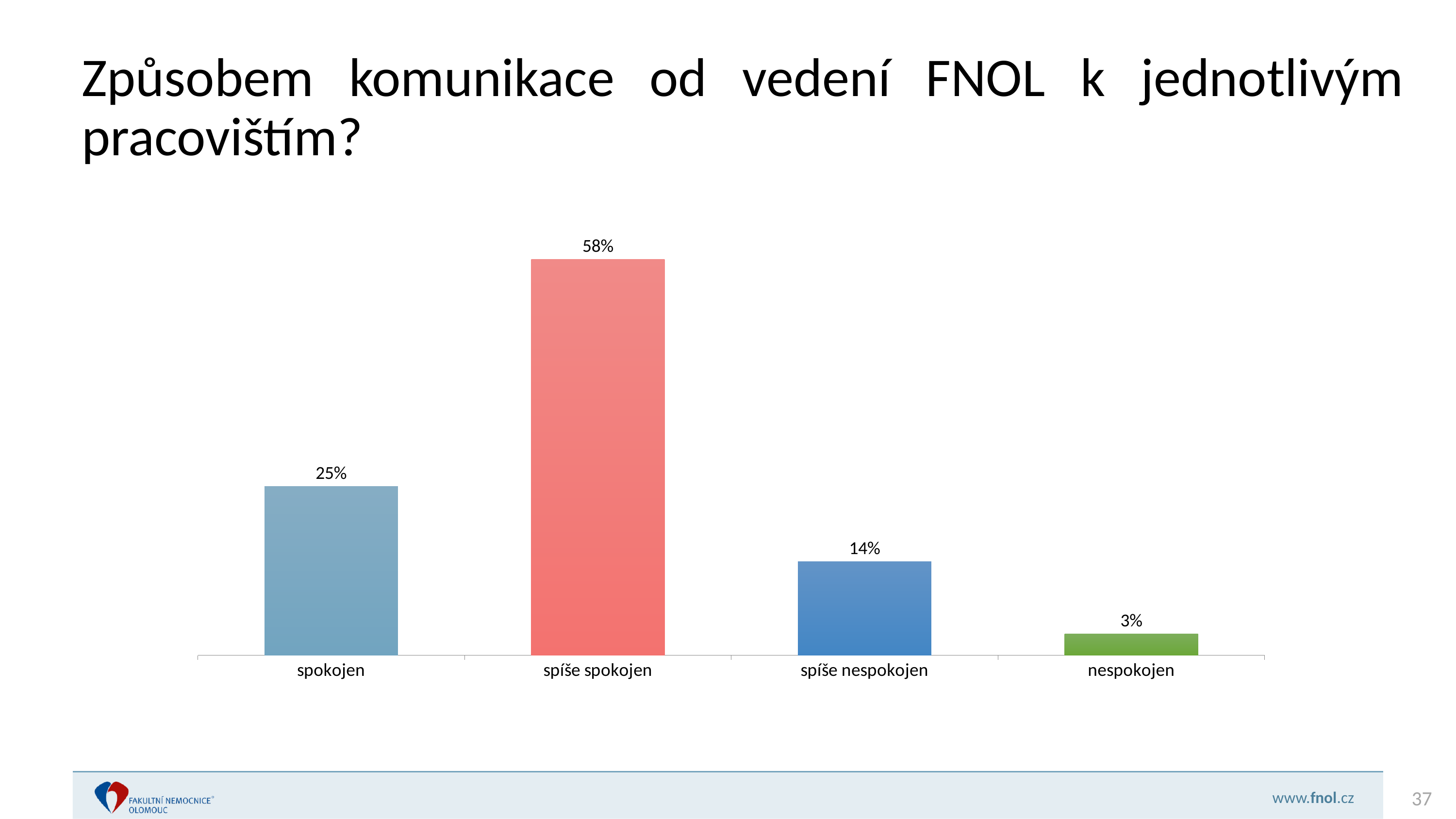
What is the value for "spokojen"? 25% What is the value for "spíše nespokojen"? 14% What kind of chart is shown on the slide? bar chart What is the value for "spíše spokojen"? 58% Which category has the highest value? spíše spokojen How many categories are shown on the x axis? 4 What is the value for "nespokojen"? 3% What is the difference between the values for "spíše nespokojen" and "nespokojen"? 11% Which category has the lowest value? nespokojen What colour is the bar for "spíše spokojen"? red Which is larger, the value for "spokojen" or the value for "spíše nespokojen"? spokojen What is the difference between the values for "spíše spokojen" and "spokojen"? 33%